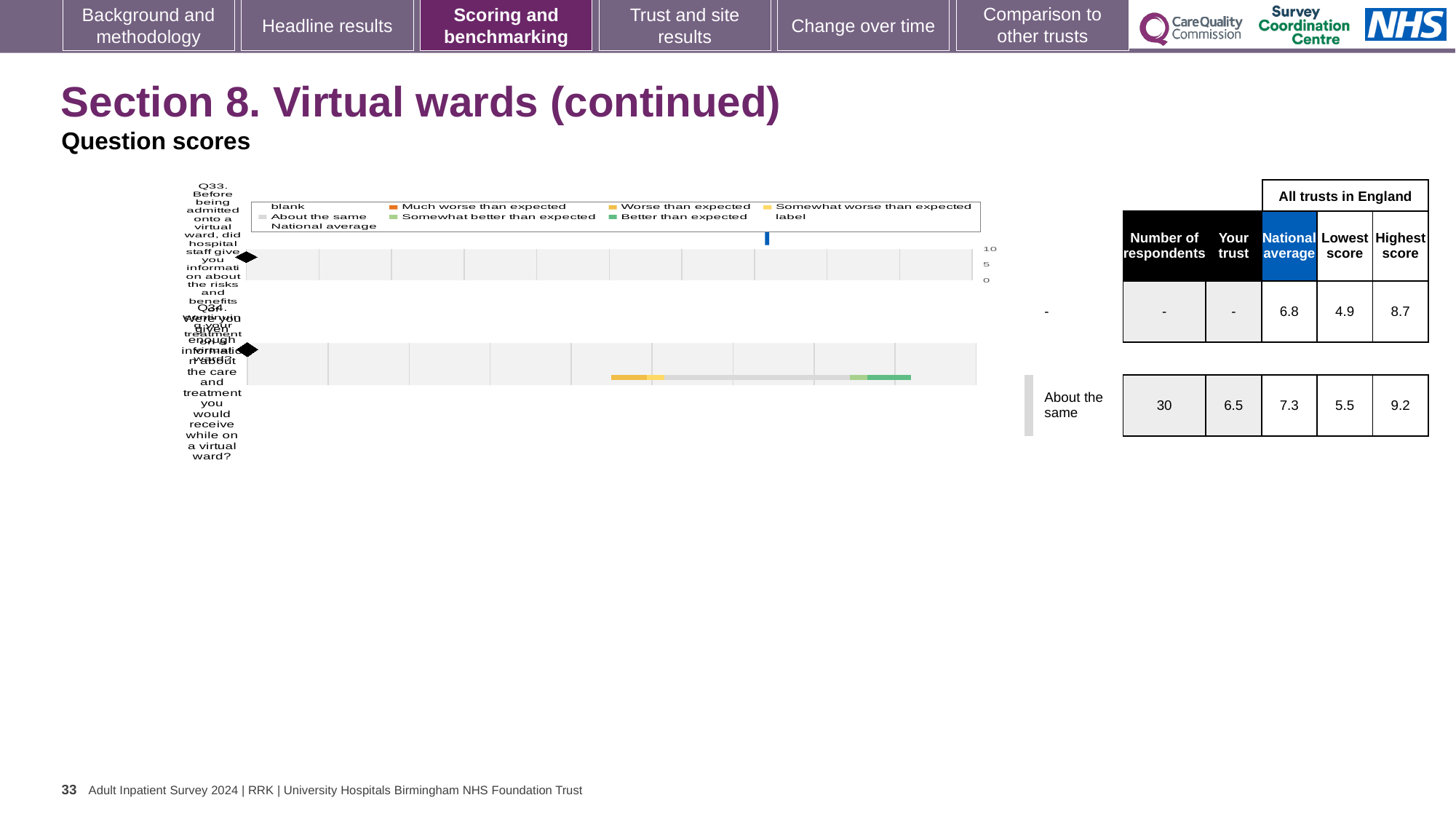
Which question is rated 'About the same' compared with other trusts? Q34 What kind of chart is shown on the slide? bar chart How many survey questions are plotted in the chart? 2 What is the difference between the highest and lowest scores for Q33? 3.8 Is the 'Your trust' score for Q34 higher or lower than the national average for Q34? lower What is the lowest score across all trusts in England for Q33? 4.9 Which question has the higher national average, Q33 or Q34? Q34 What is the 'Your trust' score for Q34? 6.5 What colour does the legend use for 'Better than expected'? green What is the highest score across all trusts in England for Q34? 9.2 What is the national average score for Q34? 7.3 What is the number of respondents for Q34? 30